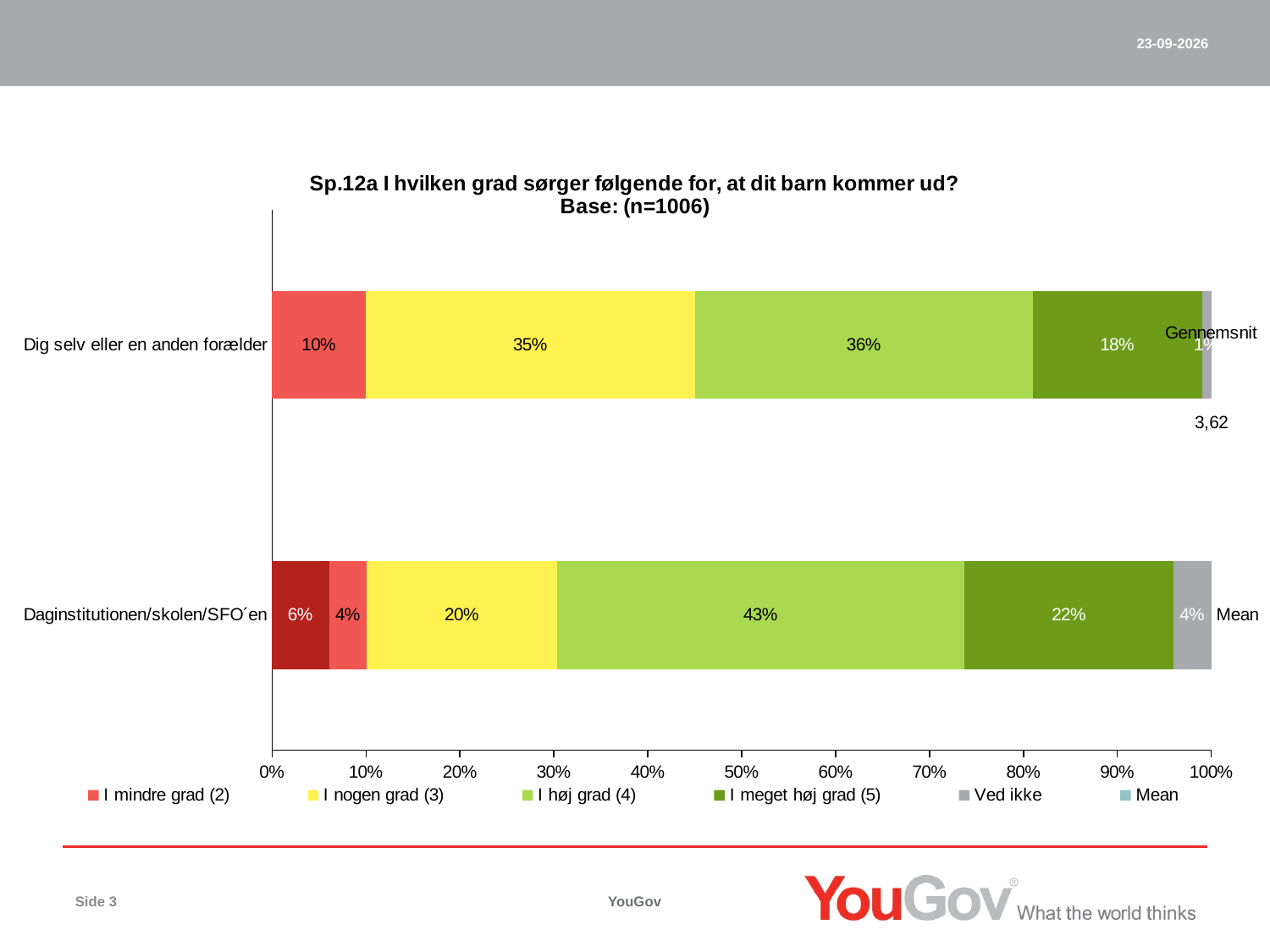
How many categories are shown on the y axis of the chart? 2 What is the 'Ved ikke' value for 'Daginstitutionen/skolen/SFO´en'? 4% What is the value for 'I meget høj grad (5)' for 'Daginstitutionen/skolen/SFO´en'? 22% What is the value for 'I nogen grad (3)' for 'Dig selv eller en anden forælder'? 35% What is the value for 'I mindre grad (2)' for 'Dig selv eller en anden forælder'? 10% What is the difference between the 'I meget høj grad (5)' values for 'Daginstitutionen/skolen/SFO´en' and 'Dig selv eller en anden forælder'? 4% What is the value for 'I høj grad (4)' for 'Daginstitutionen/skolen/SFO´en'? 43% Which category has the larger 'I høj grad (4)' value, 'Dig selv eller en anden forælder' or 'Daginstitutionen/skolen/SFO´en'? Daginstitutionen/skolen/SFO´en What is the base (n) stated in the chart title? n=1006 What is the difference between the 'I nogen grad (3)' values for 'Dig selv eller en anden forælder' and 'Daginstitutionen/skolen/SFO´en'? 15% How many series does the legend list? 6 What kind of chart is shown on the slide? stacked bar chart